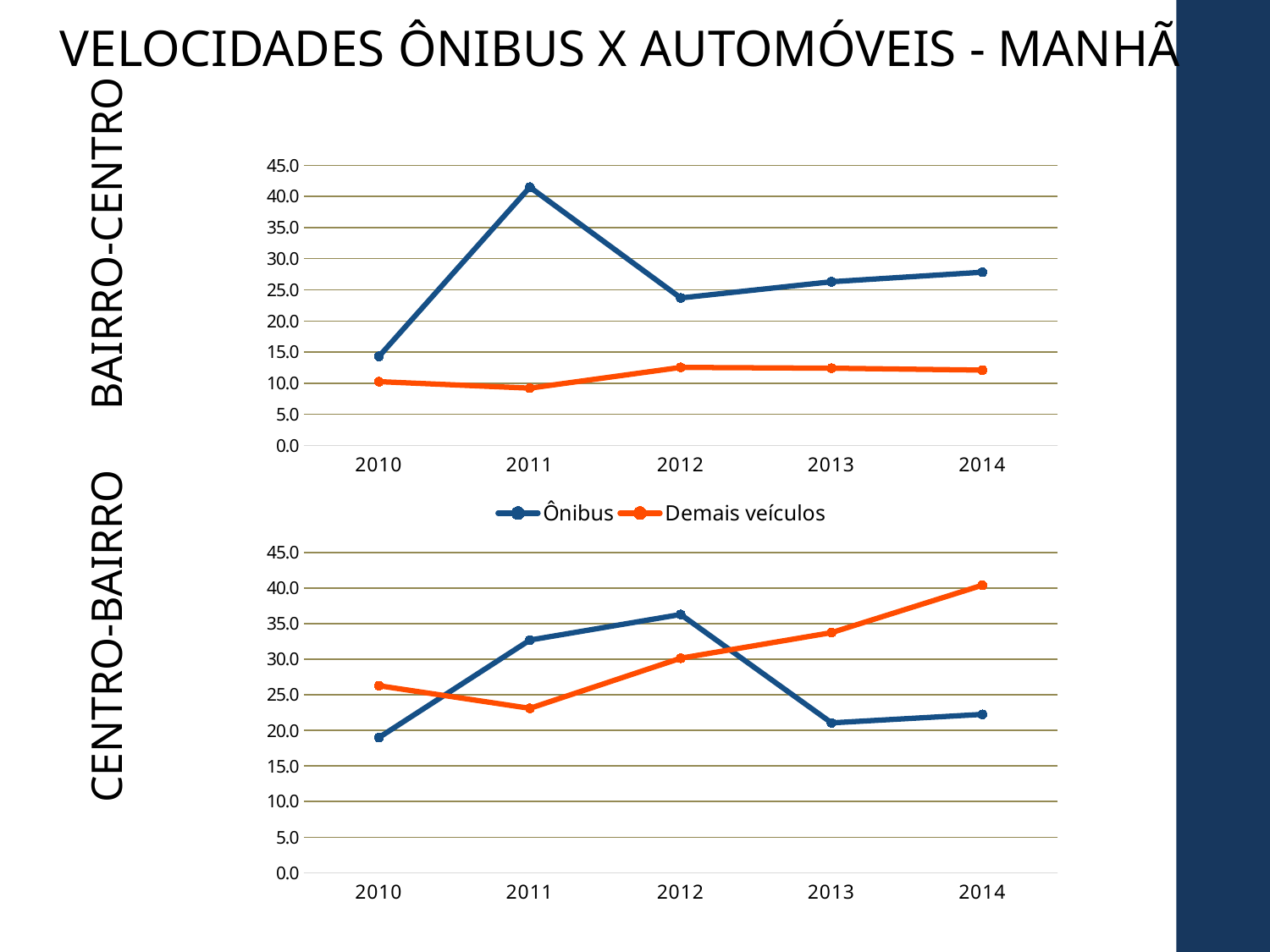
In the BAIRRO-CENTRO chart, which series has the larger value in 2012, Ônibus or Demais veículos? Ônibus How many series does the legend list for the charts on the slide? 2 In the CENTRO-BAIRRO chart, which series has the larger value in 2014, Ônibus or Demais veículos? Demais veículos What kind of chart is the BAIRRO-CENTRO chart at the top of the slide? line chart In the CENTRO-BAIRRO chart, in which year is the Demais veículos value highest? 2014 In the BAIRRO-CENTRO chart, is the Ônibus value for 2011 greater or less than 40.0? greater In the BAIRRO-CENTRO chart, is the Demais veículos value for 2011 greater or less than 10.0? less In the BAIRRO-CENTRO chart, in which year is the Ônibus value highest? 2011 In the CENTRO-BAIRRO chart, does the Demais veículos line rise or fall from 2011 to 2014? rise How many years are plotted along the x axis of the CENTRO-BAIRRO chart? 5 In the CENTRO-BAIRRO chart, in which year is the Ônibus value lowest? 2010 In the BAIRRO-CENTRO chart, in which year is the Ônibus value lowest? 2010